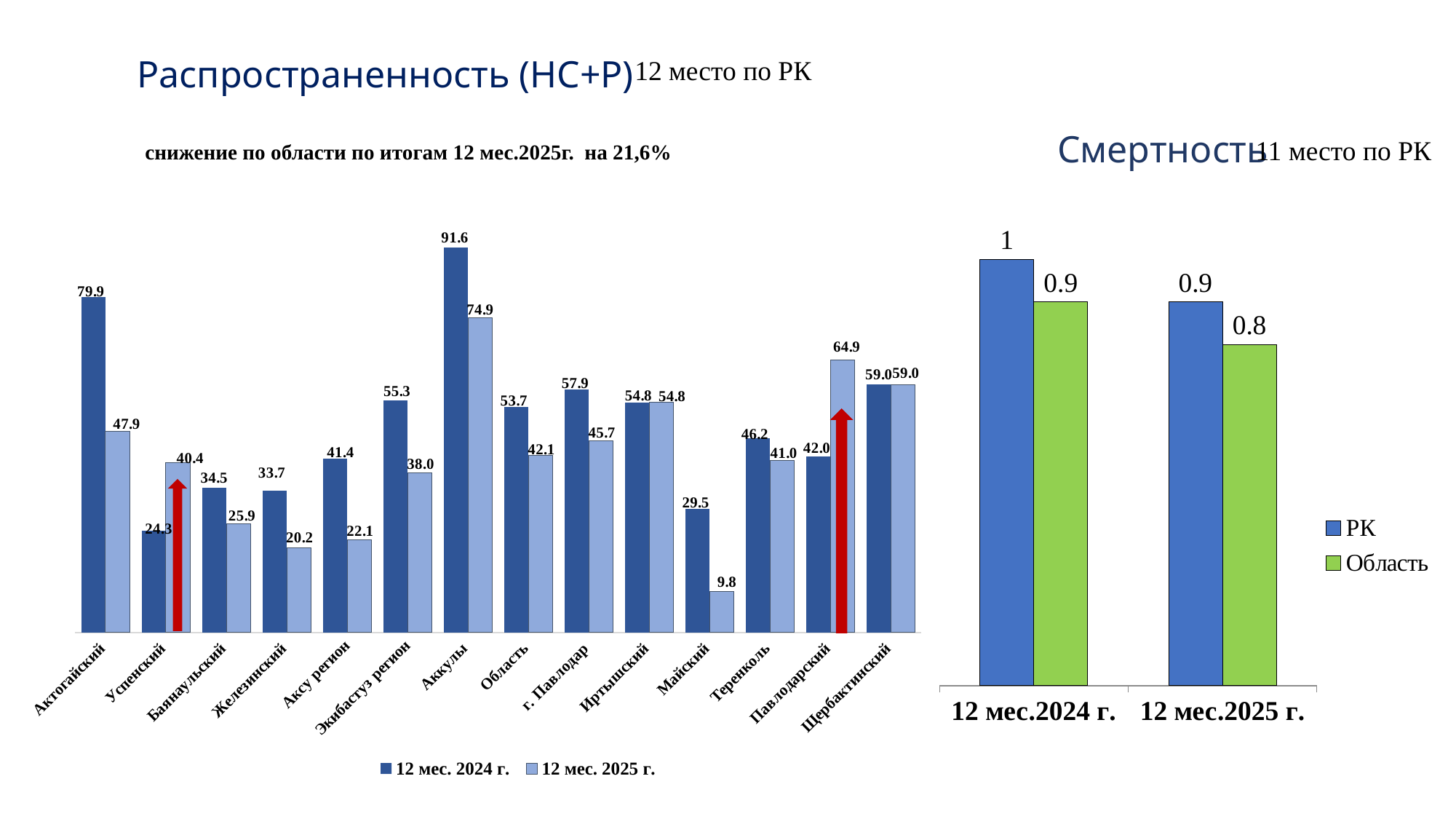
In the right chart (Смертность), what kind of chart is shown? Bar chart In the left chart (Распространенность), how many categories are shown on the x axis? 14 In the left chart (Распространенность), which category has the lowest value for 12 мес. 2025 г.? Майский In the right chart (Смертность), what is the value for Область for 12 мес.2025 г.? 0.8 In the left chart (Распространенность), which is larger for Павлодарский: the 12 мес. 2024 г. value or the 12 мес. 2025 г. value? 12 мес. 2025 г. In the left chart (Распространенность), what is the value for Майский for 12 мес. 2025 г.? 9.8 In the left chart (Распространенность), what is the difference between the 12 мес. 2024 г. and 12 мес. 2025 г. values for Актогайский? 32.0 In the right chart (Смертность), what colour are the Область bars? Green In the left chart (Распространенность), what is the value for Аккулы for 12 мес. 2024 г.? 91.6 In the left chart (Распространенность), how many series does the legend list? 2 In the right chart (Смертность), what is the value for РК for 12 мес.2024 г.? 1 In the left chart (Распространенность), which category has the highest value for 12 мес. 2024 г.? Аккулы